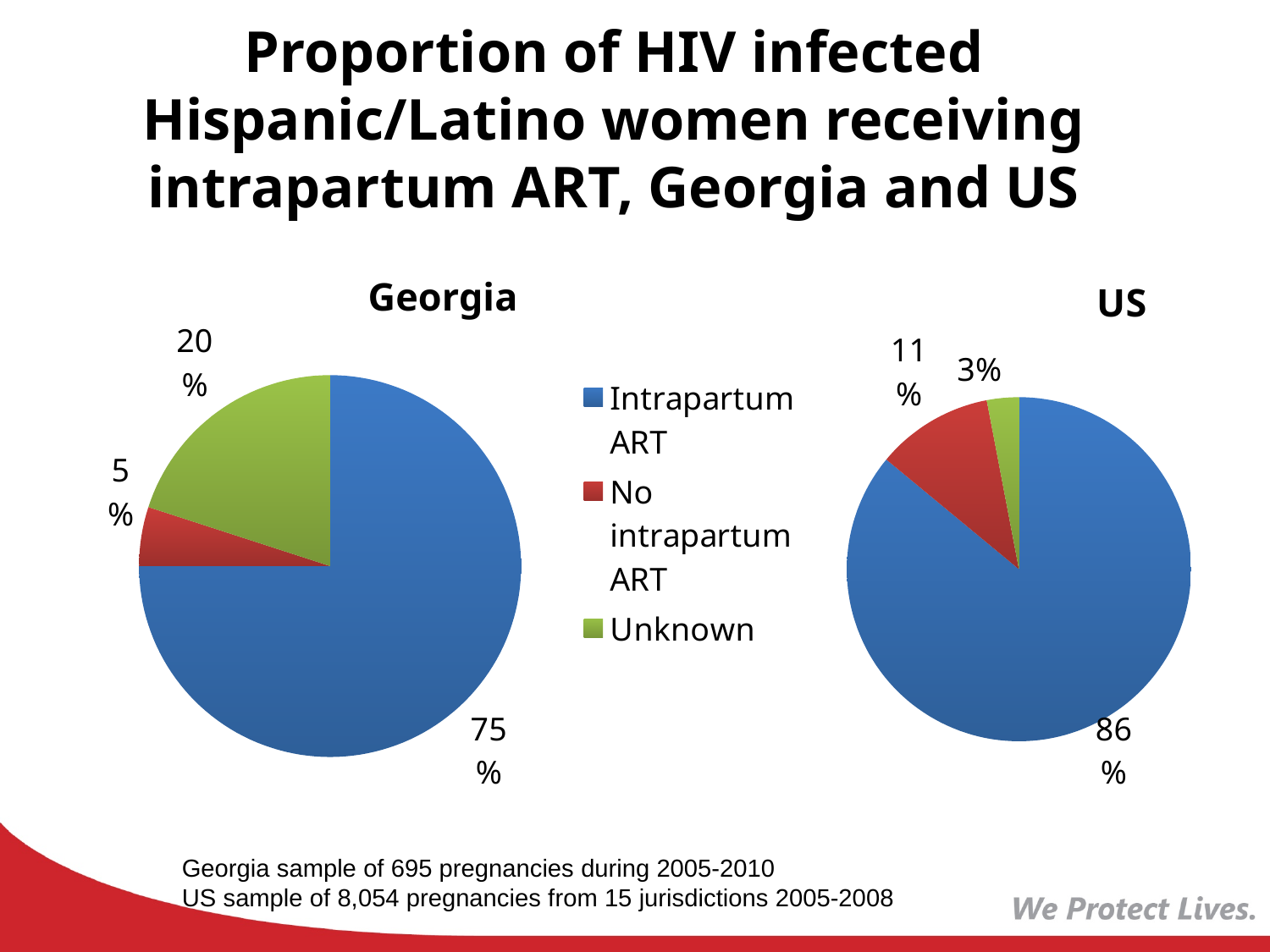
In the Georgia pie chart, what share is labelled Unknown? 20% What is the difference between the US and Georgia shares of women receiving intrapartum ART? 11% In the US pie chart, which category has the smallest slice? Unknown In the US pie chart, what share is labelled Unknown? 3% In the US pie chart, what share of women received intrapartum ART? 86% How many categories does the legend list? 3 What type of chart is used for the Georgia and US data? Pie chart In the Georgia pie chart, which category has the largest slice? Intrapartum ART Which has a larger Unknown share, the Georgia pie chart or the US pie chart? Georgia